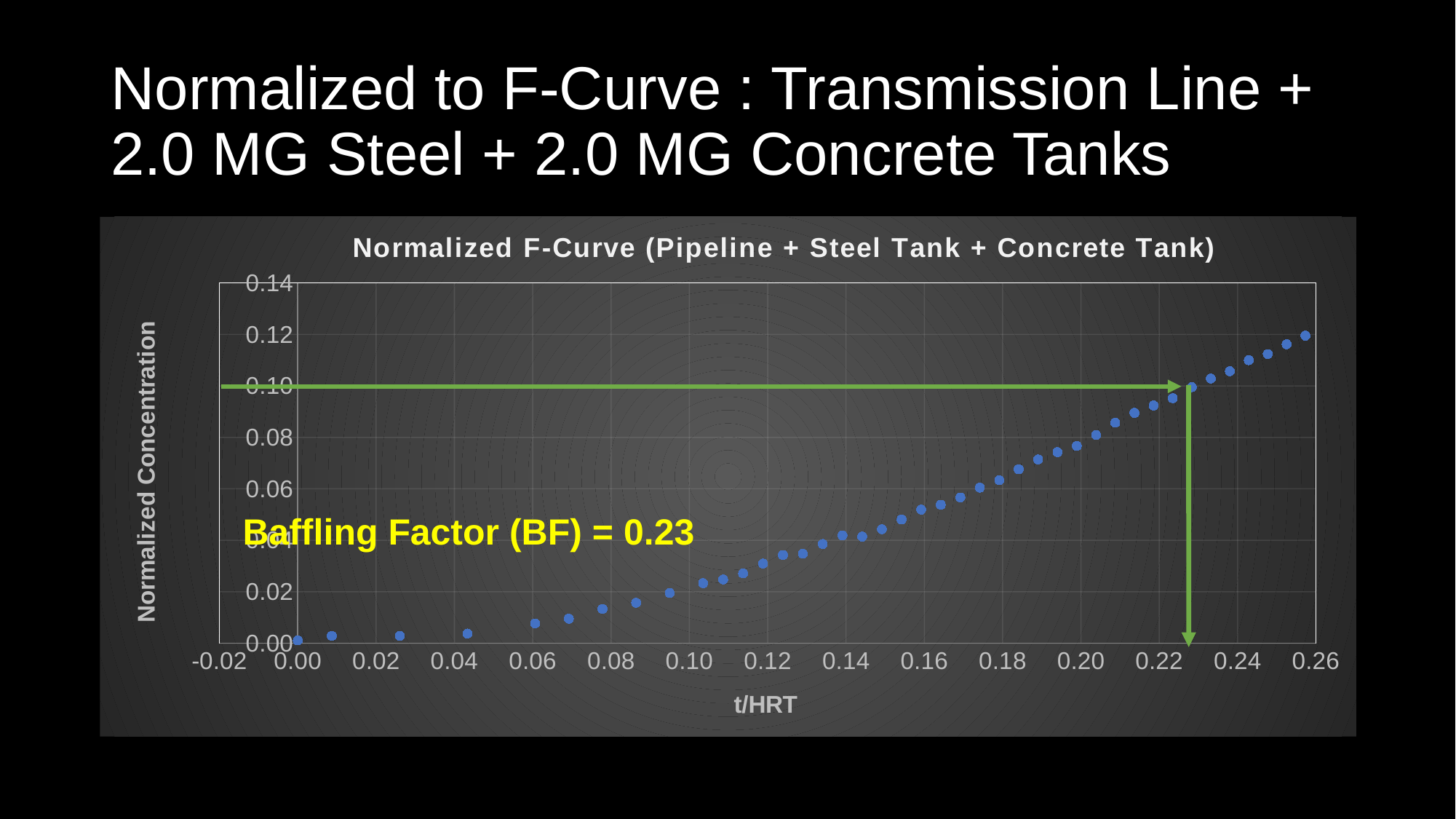
Is the normalized concentration at t/HRT = 0.26 greater or less than 0.10? greater What Baffling Factor (BF) value is stated on the chart? 0.23 What is the highest value shown on the y axis? 0.14 Is the normalized concentration at t/HRT = 0.20 greater or less than 0.06? greater Is the normalized concentration at t/HRT = 0.10 greater or less than 0.04? less What kind of chart is shown on the slide? scatter chart Which has the higher normalized concentration: the point at t/HRT = 0.06 or the point at t/HRT = 0.16? t/HRT = 0.16 What is the label of the x axis? t/HRT Do the plotted values rise or fall as t/HRT increases? rise What is the title of the chart? Normalized F-Curve (Pipeline + Steel Tank + Concrete Tank)